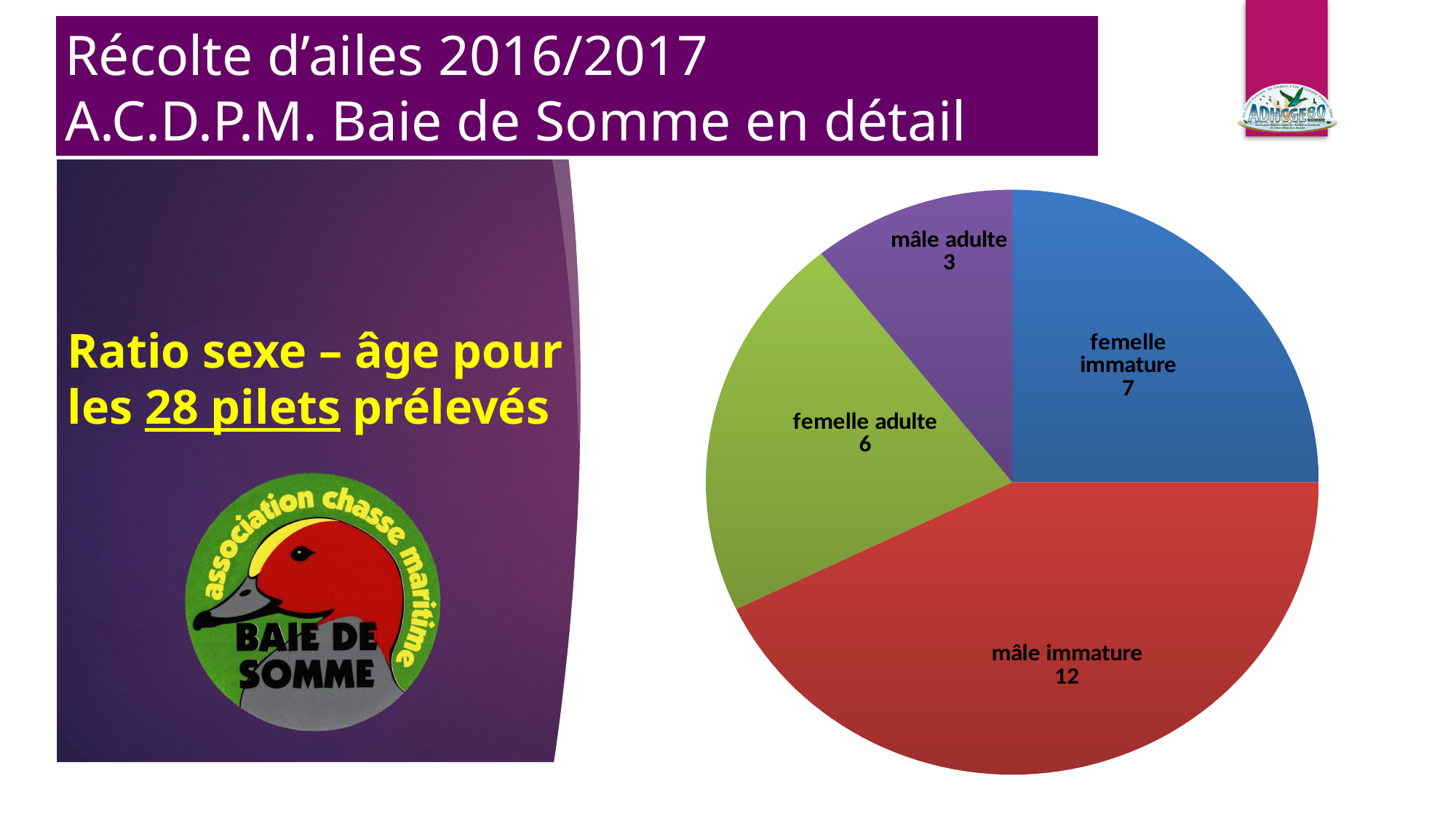
Which is larger, femelle immature or femelle adulte? femelle immature What kind of chart is shown on the slide? pie chart What is the value for mâle adulte? 3 Which category has the smallest slice? mâle adulte What is the value for femelle adulte? 6 How many slices does the pie chart have? 4 What colour is the mâle immature slice? red What is the value for femelle immature? 7 What is the difference between the values for mâle immature and femelle immature? 5 Which category has the largest slice? mâle immature What is the value for mâle immature? 12